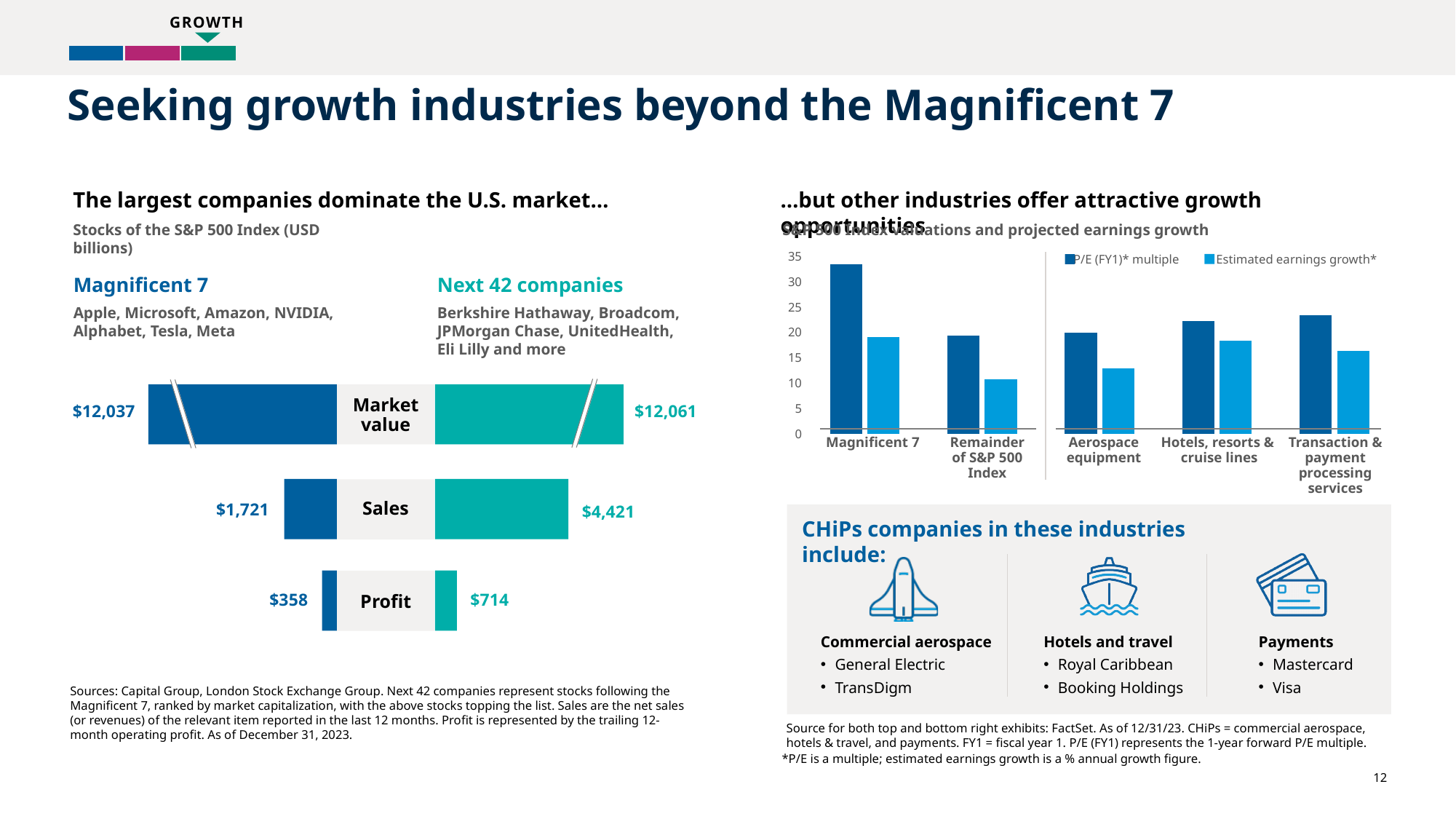
How many series does the legend of the right chart (S&P 500 Index valuations and projected earnings growth) list? 2 In the right chart (S&P 500 Index valuations and projected earnings growth), which category has the lowest estimated earnings growth? Remainder of S&P 500 Index In the left chart (Stocks of the S&P 500 Index), what is the difference between the sales of the Next 42 companies and the sales of the Magnificent 7? $2,700 In the right chart (S&P 500 Index valuations and projected earnings growth), is the estimated earnings growth for the Remainder of S&P 500 Index greater or less than 15? less In the right chart (S&P 500 Index valuations and projected earnings growth), is the P/E (FY1) multiple for the Magnificent 7 greater or less than 30? greater How many categories are shown on the x axis of the right chart (S&P 500 Index valuations and projected earnings growth)? 5 In the left chart (Stocks of the S&P 500 Index), what is the market value of the Magnificent 7? $12,037 In the right chart (S&P 500 Index valuations and projected earnings growth), which category has the highest P/E (FY1) multiple? Magnificent 7 In the left chart (Stocks of the S&P 500 Index), what is the profit of the Magnificent 7? $358 In the left chart (Stocks of the S&P 500 Index), what are the sales of the Next 42 companies? $4,421 In the left chart (Stocks of the S&P 500 Index), which group has the larger profit, the Magnificent 7 or the Next 42 companies? Next 42 companies In the left chart (Stocks of the S&P 500 Index), what is the difference between the profit of the Next 42 companies and the profit of the Magnificent 7? $356